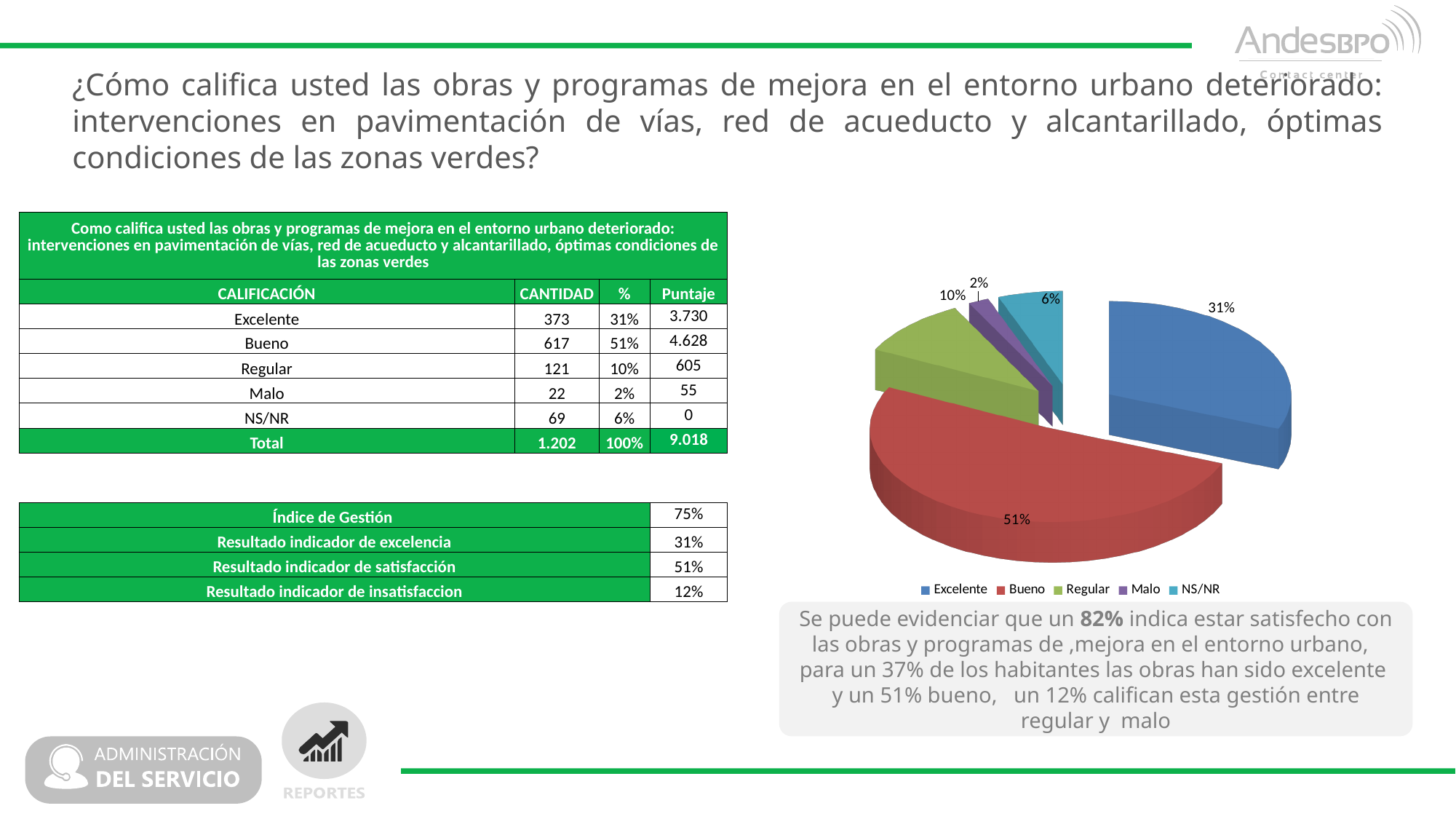
What kind of chart is shown on the slide? pie chart What share of the pie does Bueno represent? 51% How many categories does the pie chart show? 5 Which category has the largest slice of the pie? Bueno Which slice is larger, Regular or NS/NR? Regular What share of the pie does Regular represent? 10% What share of the pie does NS/NR represent? 6% What colour is the Bueno slice in the pie chart? red What is the difference in percentage points between the Bueno and Excelente slices? 20% Which category has the smallest slice of the pie? Malo